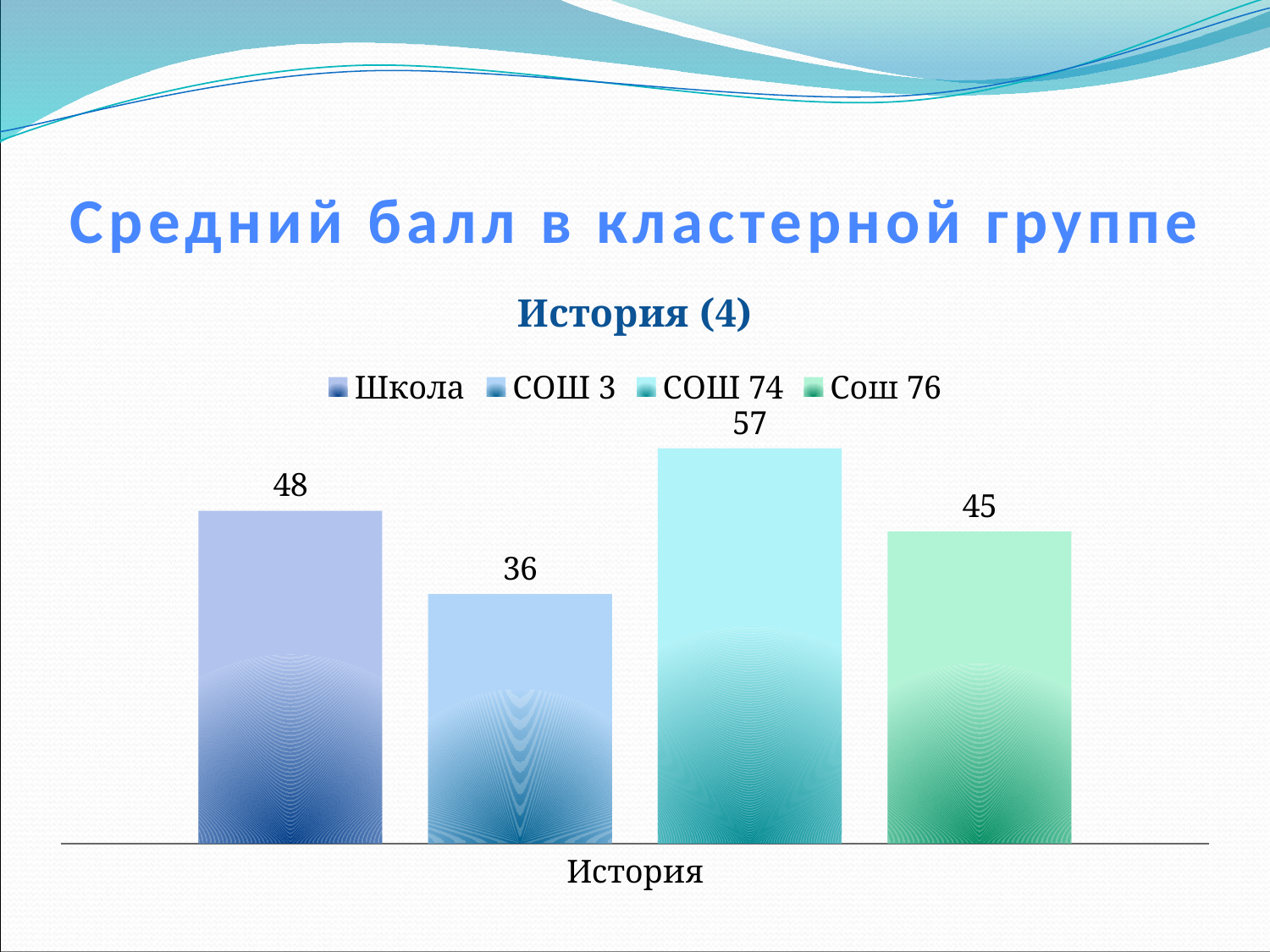
What is the value for Школа? 48 What is the difference between the values for Школа and Сош 76? 3 What is the title of the chart? История (4) How many series does the legend list? 4 Which series has the highest value? СОШ 74 What is the value for СОШ 3? 36 What is the difference between the values for СОШ 74 and СОШ 3? 21 Which series has the lowest value? СОШ 3 What kind of chart is shown? Bar chart What is the value for СОШ 74? 57 Which is larger, the value for Школа or the value for Сош 76? Школа What is the value for Сош 76? 45